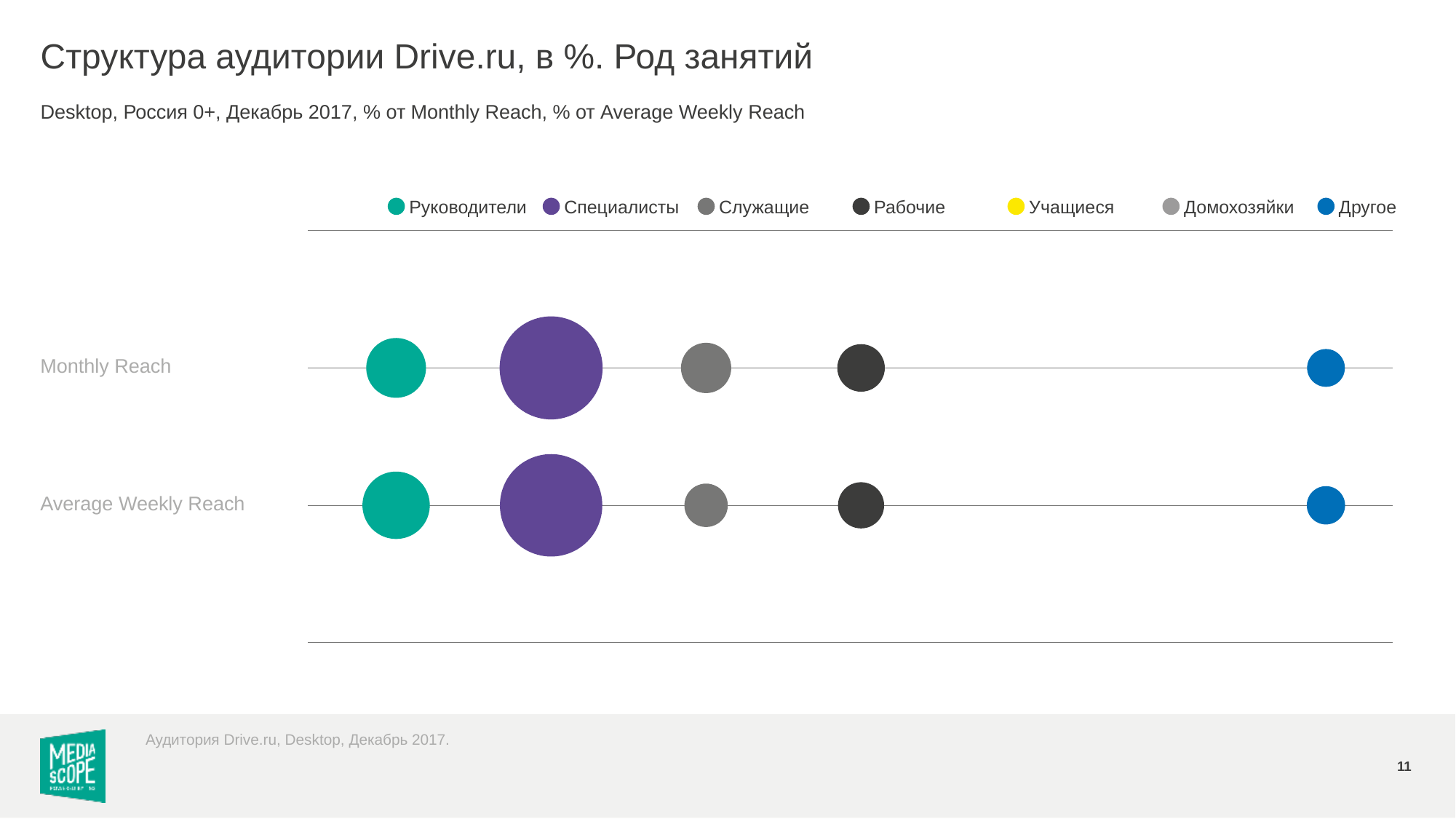
How many rows (categories) are plotted on the chart? 2 In the Average Weekly Reach row, which bubble is larger: Руководители or Служащие? Руководители Which occupation group has the largest bubble in the Monthly Reach row? Специалисты Which occupation group has the largest bubble in the Average Weekly Reach row? Специалисты Which legend entry is shown in purple? Специалисты In the Monthly Reach row, which bubble is larger: Служащие or Другое? Служащие What kind of chart is shown on the slide? Bubble chart How many series does the legend list? 7 In the Monthly Reach row, which bubble is larger: Специалисты or Руководители? Специалисты What are the labels of the two rows plotted on the chart? Monthly Reach, Average Weekly Reach What is the title of the chart on the slide? Структура аудитории Drive.ru, в %. Род занятий